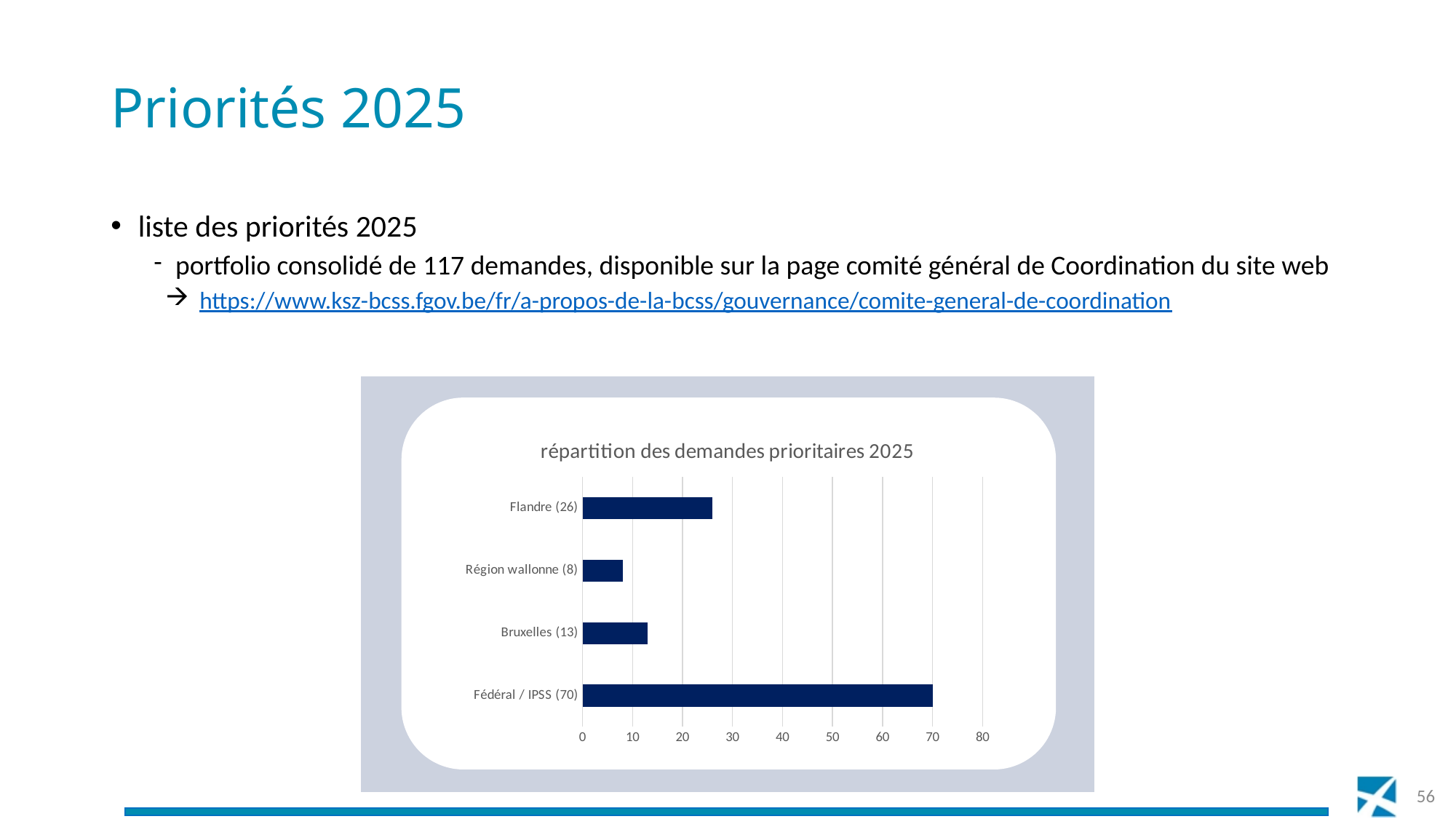
What is the value for Région wallonne? 8 What type of chart is shown on the slide? bar chart Is the value for Flandre greater or less than 30? less How many categories does the chart show? 4 What is the value for Flandre? 26 What is the difference between the values for Fédéral / IPSS and Flandre? 44 What is the title of the chart? répartition des demandes prioritaires 2025 Which category has the highest value? Fédéral / IPSS Which is larger, the value for Bruxelles or the value for Région wallonne? Bruxelles What is the value for Fédéral / IPSS? 70 What is the value for Bruxelles? 13 Which category has the lowest value? Région wallonne